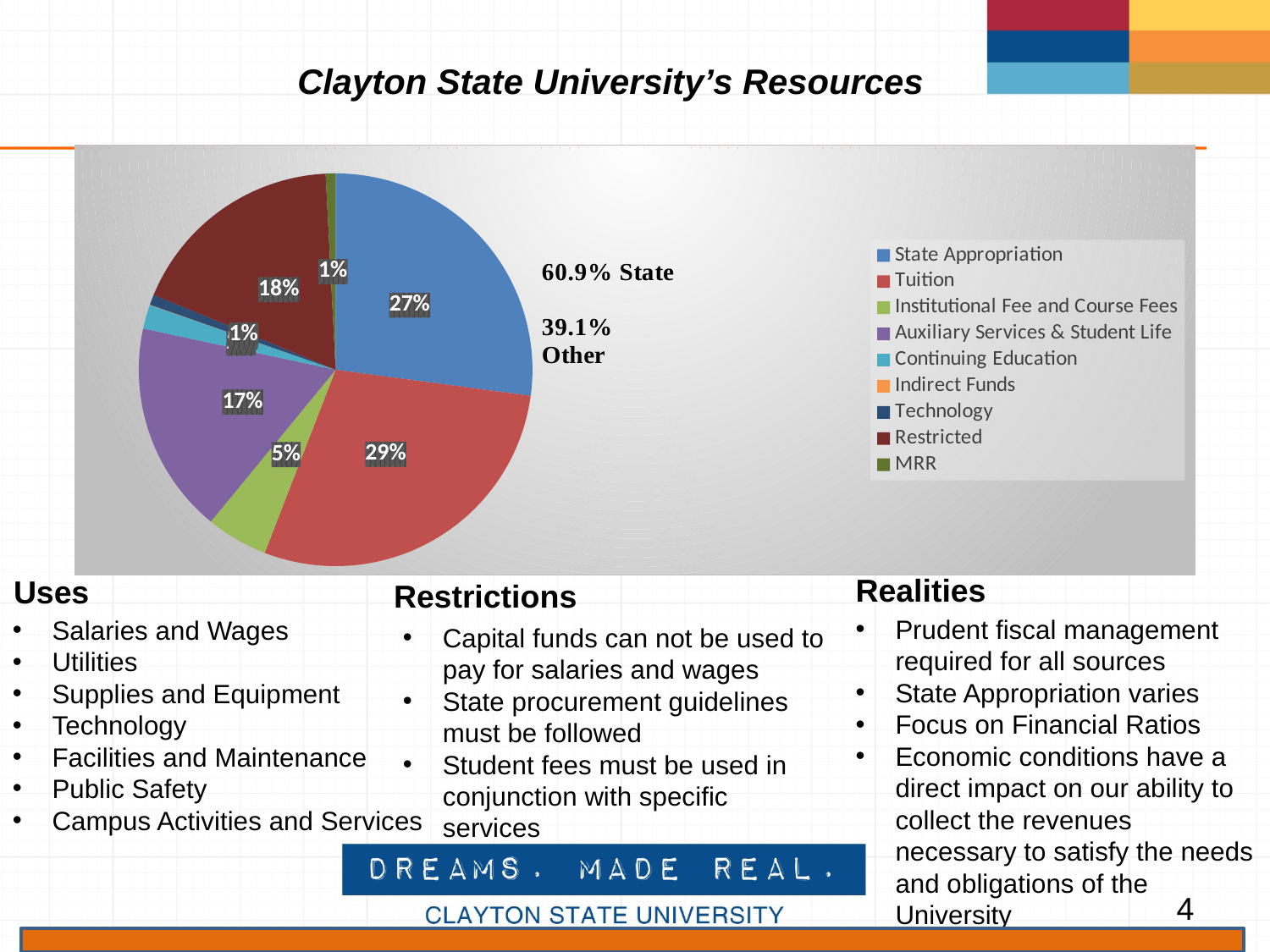
What percentage of resources is Restricted? 18% What percentage of resources comes from Auxiliary Services & Student Life? 17% Which category has the largest share of the pie? Tuition What percentage of resources comes from Tuition? 29% How many categories does the legend of the pie chart list? 9 What is the title of the slide containing the pie chart? Clayton State University's Resources What kind of chart is shown on the slide? pie chart By how many percentage points does the Tuition share exceed the State Appropriation share? 2 Which is larger, the share for State Appropriation or the share for Restricted? State Appropriation What percentage of resources comes from Institutional Fee and Course Fees? 5% According to the text next to the pie chart, what percentage of resources is labelled as State? 60.9% What percentage of resources comes from State Appropriation? 27%